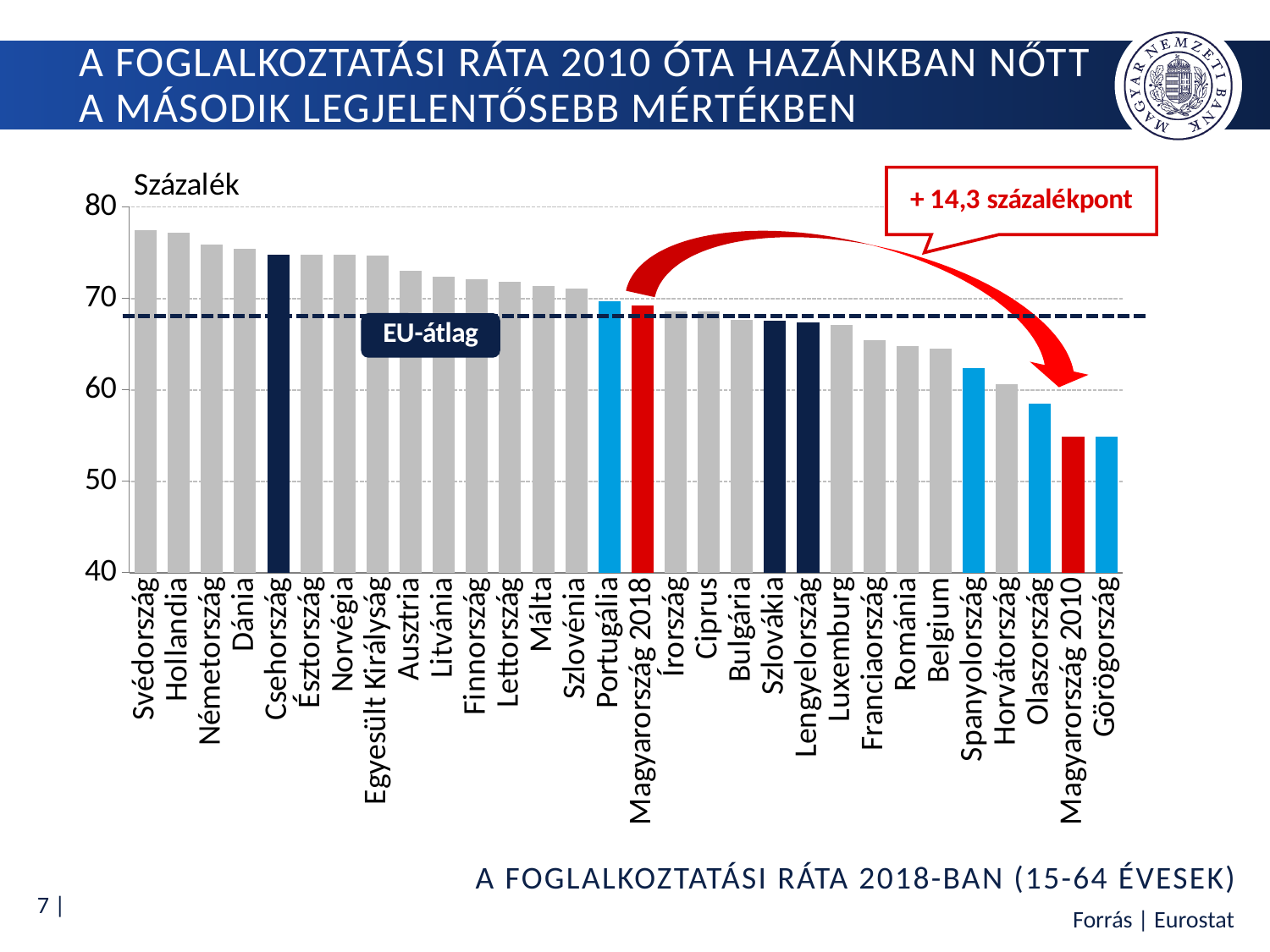
What kind of chart is shown on the slide? Bar chart How many countries/bars are plotted in the chart? 30 Is the value for Görögország greater or less than 60? less Which has the larger value, Magyarország 2018 or Magyarország 2010? Magyarország 2018 Which has the larger value, Dánia or Belgium? Dánia According to the callout, by how much did Hungary's employment rate change between 2010 and 2018? + 14,3 százalékpont What unit label is shown at the top of the vertical axis? Százalék Is the value for Belgium greater or less than 70? less Is the value for Magyarország 2018 greater or less than 60? greater What does the horizontal dashed line in the chart represent, according to its label? EU-átlag Do the bar values rise or fall from left to right along the x axis? Fall